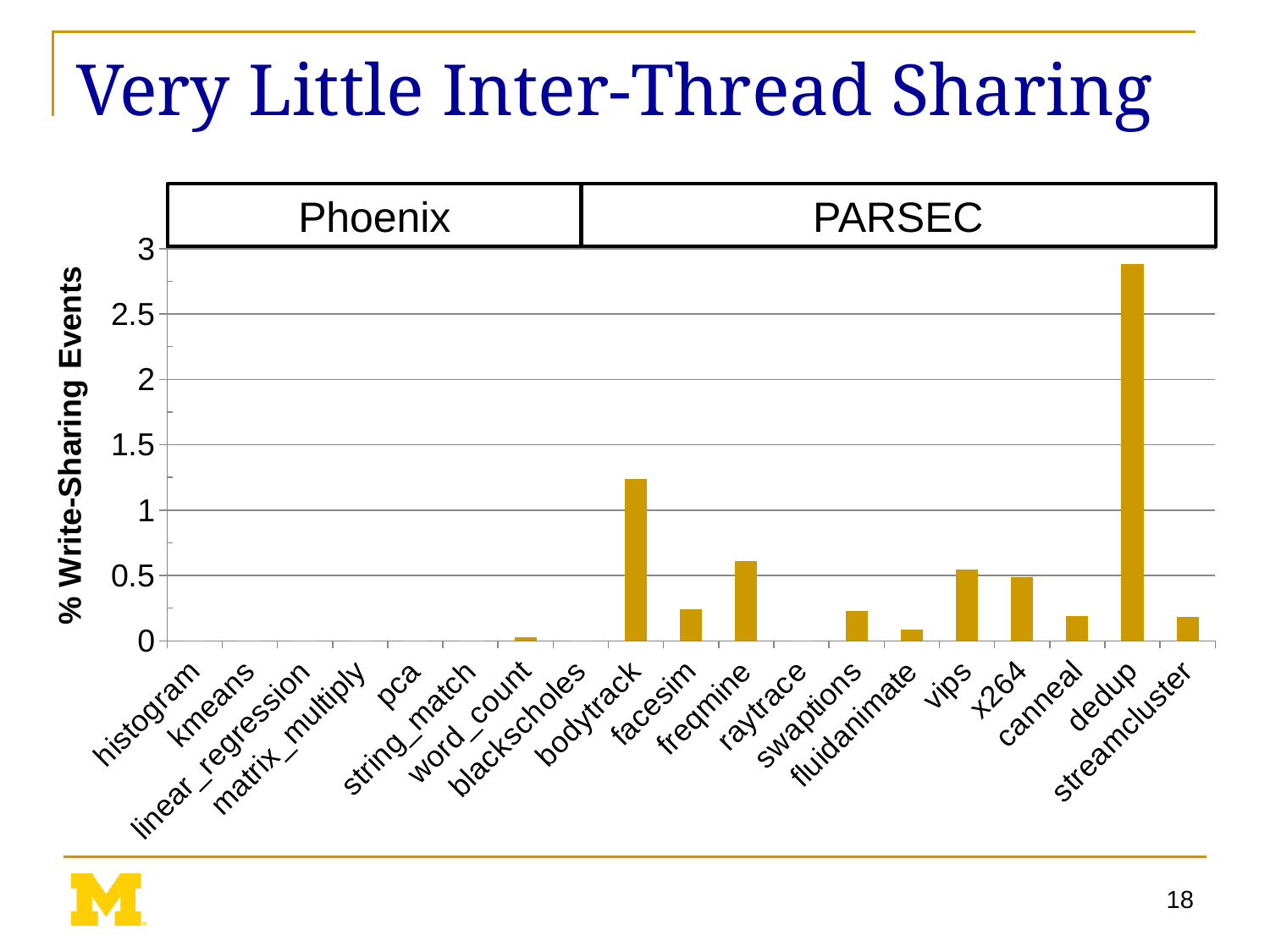
What are the two benchmark suite groups labelled above the chart? Phoenix and PARSEC Which has a higher % Write-Sharing Events, bodytrack or freqmine? bodytrack Is the value for fluidanimate greater or less than 0.5? less Is the value for dedup greater or less than 2.5? greater Which has a higher % Write-Sharing Events, facesim or vips? vips Is the value for facesim greater or less than 0.5? less How many benchmark categories are plotted along the x axis? 19 Which benchmark has the highest % Write-Sharing Events? dedup What kind of chart is shown on the slide? bar chart What is the label of the y axis? % Write-Sharing Events